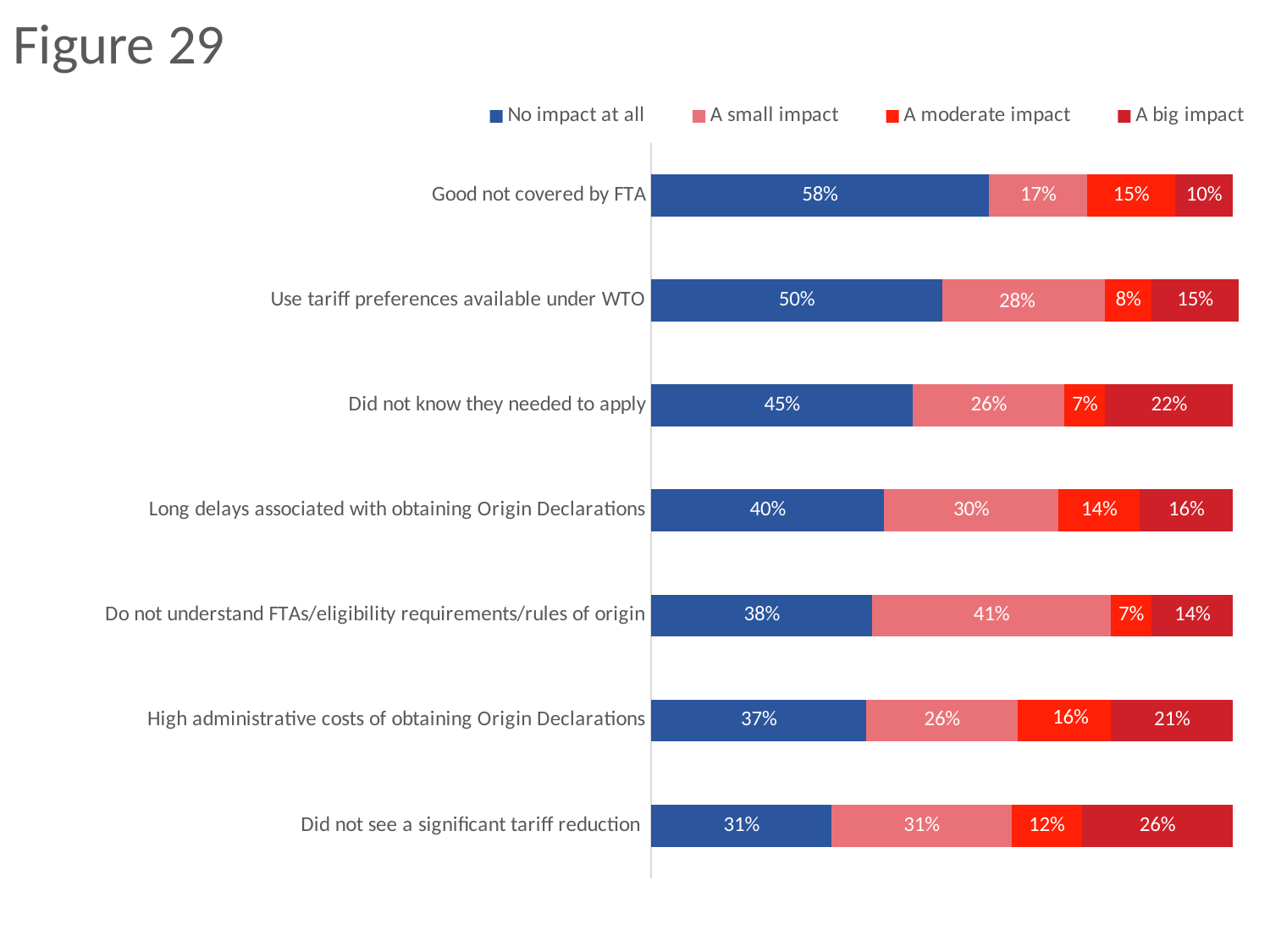
What percentage of respondents said 'Good not covered by FTA' had no impact at all? 58% Which category has the highest 'A big impact' value? Did not see a significant tariff reduction What is the 'A big impact' value for 'Did not see a significant tariff reduction'? 26% How many series does the legend list? 4 What is the difference between the 'No impact at all' values for 'Good not covered by FTA' and 'Use tariff preferences available under WTO'? 8% What kind of chart is shown on the slide? Stacked bar chart Which is larger: the 'A big impact' value for 'Did not know they needed to apply' or for 'High administrative costs of obtaining Origin Declarations'? Did not know they needed to apply What is the 'A small impact' value for 'Do not understand FTAs/eligibility requirements/rules of origin'? 41% What is the 'A moderate impact' value for 'High administrative costs of obtaining Origin Declarations'? 16% How many categories are shown in the chart? 7 Which category has the lowest 'No impact at all' value? Did not see a significant tariff reduction Which category has the highest 'No impact at all' value? Good not covered by FTA